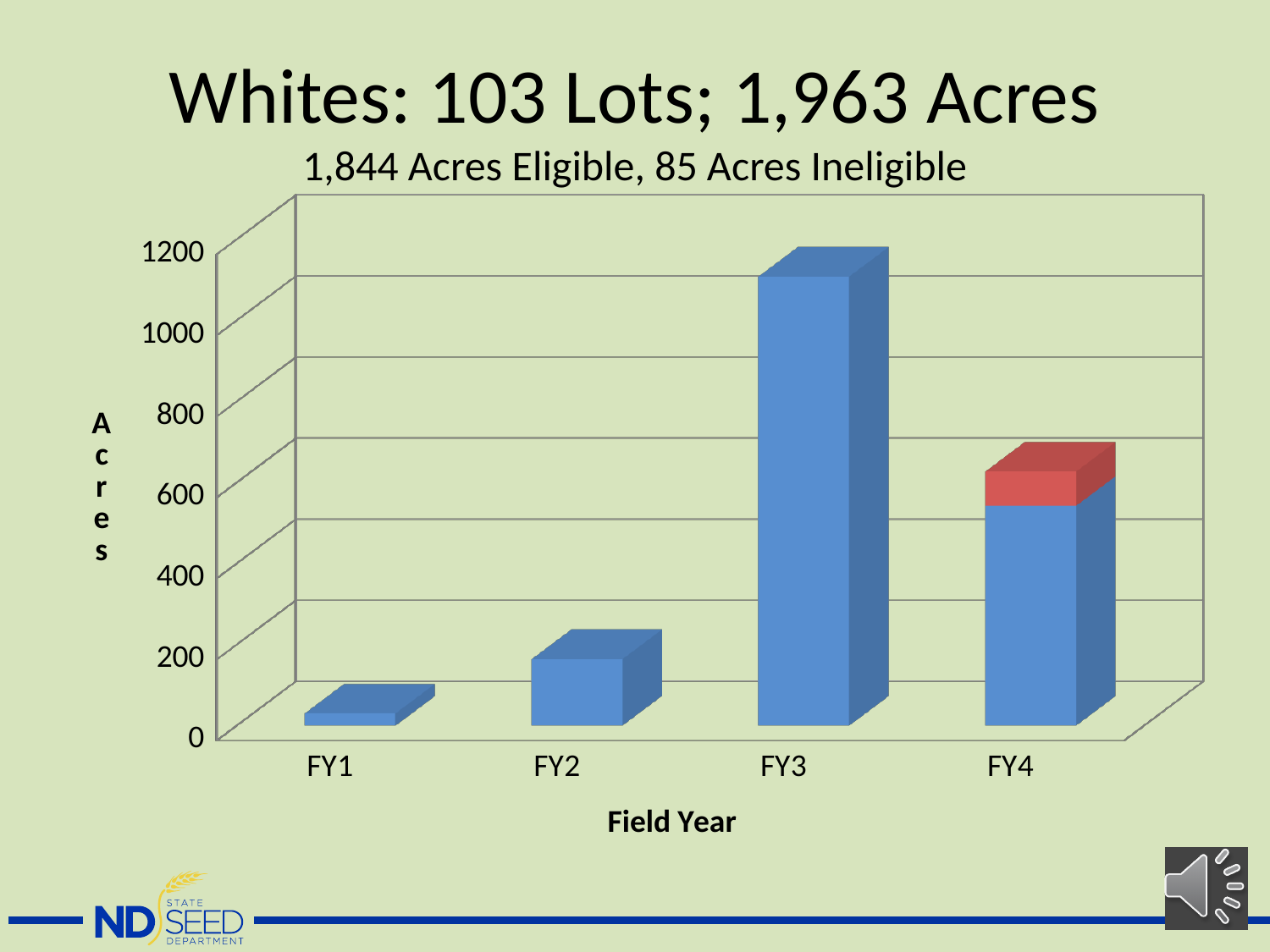
What kind of chart is shown on the slide? Bar chart What is the label on the x axis of the chart? Field Year Which has more acres, FY2 or FY4? FY4 Is the value for FY1 greater or less than 200? less Is the value for FY2 greater or less than 400? less Which field year has the lowest number of acres? FY1 How many field years are shown on the x axis of the chart? 4 Is the total height of the FY4 bar greater or less than 400? greater Which field year has the highest number of acres? FY3 Which has more acres, FY3 or FY4? FY3 Do the values rise or fall from FY1 to FY3? rise